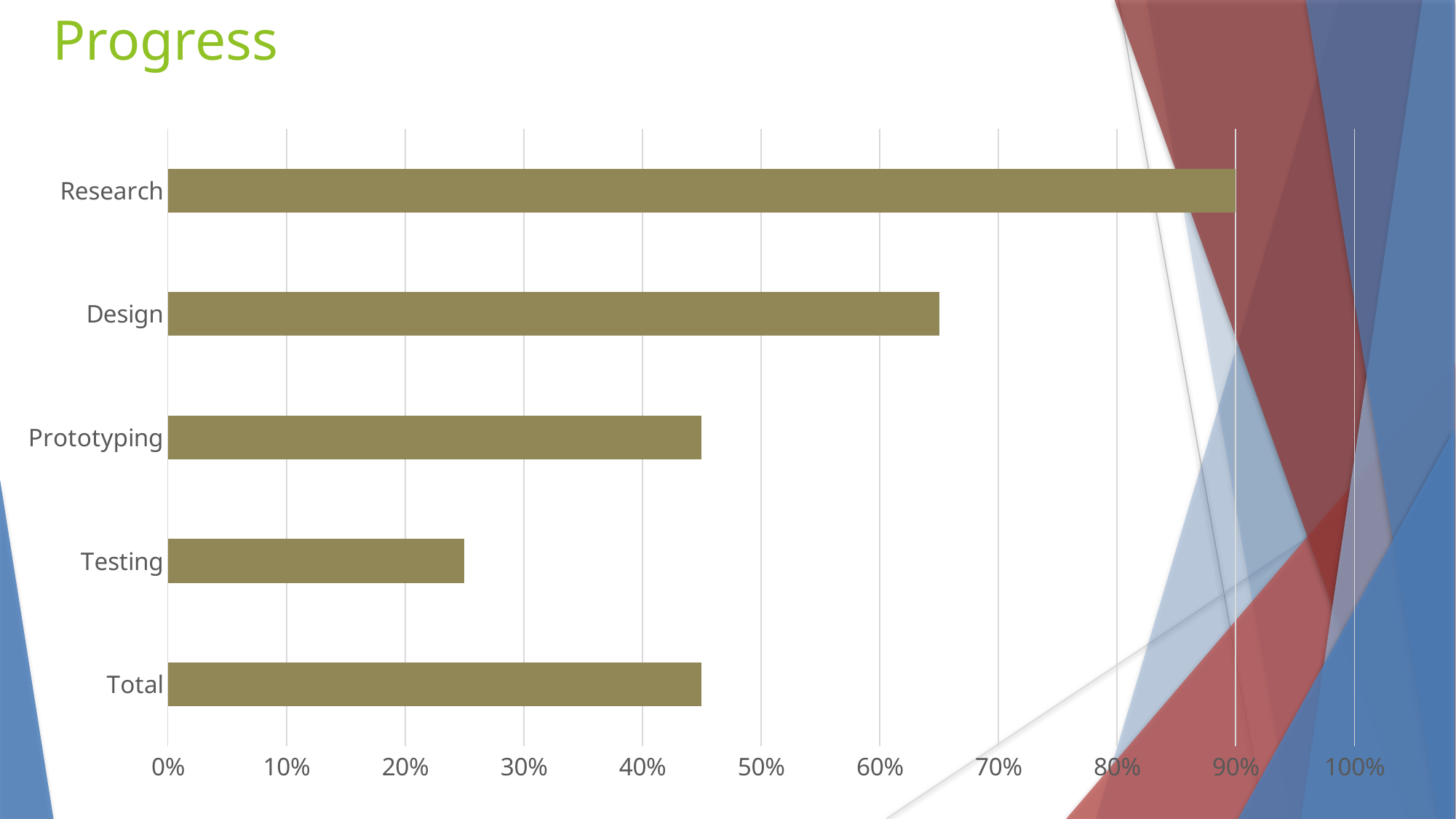
Is the value for Testing greater or less than 30%? less Is the value for Design greater or less than 60%? greater Which is larger, the value for Design or the value for Prototyping? Design What kind of chart is shown on the slide? bar chart Is the value for Total greater or less than 50%? less How many categories are plotted in the chart? 5 Which is larger, the value for Testing or the value for Total? Total Which category has the lowest value? Testing What is the value for Research? 90% Which category has the highest value? Research What is the title of the slide? Progress